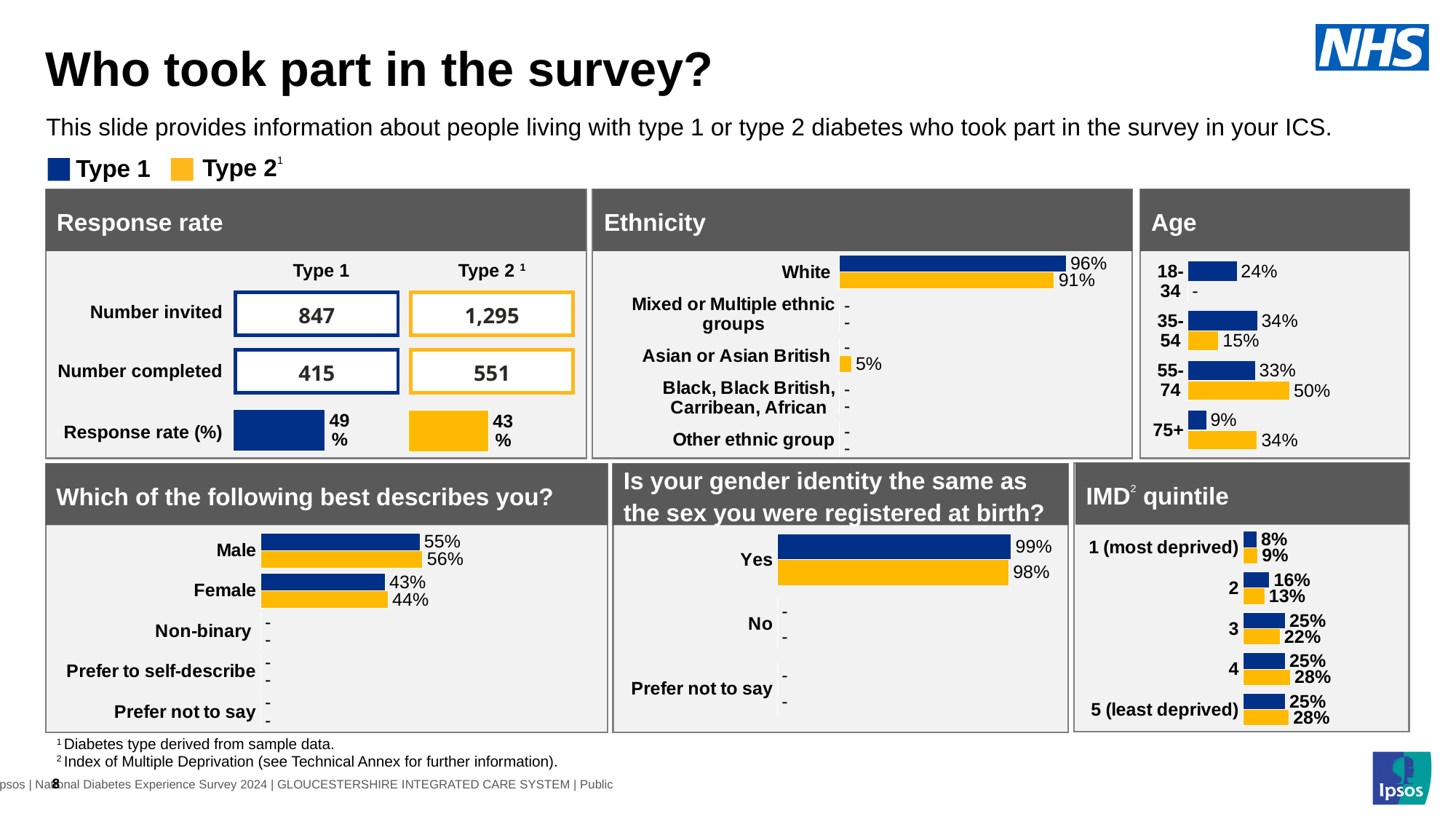
In the Ethnicity chart, what is the Type 2 value for Asian or Asian British? 5% In the Age chart, which age group has the lowest Type 1 value? 75+ In the Age chart, what is the difference between the Type 2 and Type 1 values for 75+? 25 percentage points How many series does the legend at the top of the slide list? 2 In the Response rate chart, what is the number invited for Type 1? 847 In the 'Is your gender identity the same as the sex you were registered at birth?' chart, what is the Type 2 value for Yes? 98% In the Age chart, which age group has the highest Type 2 value? 55-74 In the Ethnicity chart, what is the Type 2 value for White? 91% In the IMD quintile chart, which quintile has the lowest Type 1 value? 1 (most deprived) In the Response rate chart, what is the difference between the Type 1 and Type 2 response rates? 6 percentage points In the Response rate chart, what is the number completed for Type 2? 551 In the 'Which of the following best describes you?' chart, what is the Type 1 value for Female? 43%